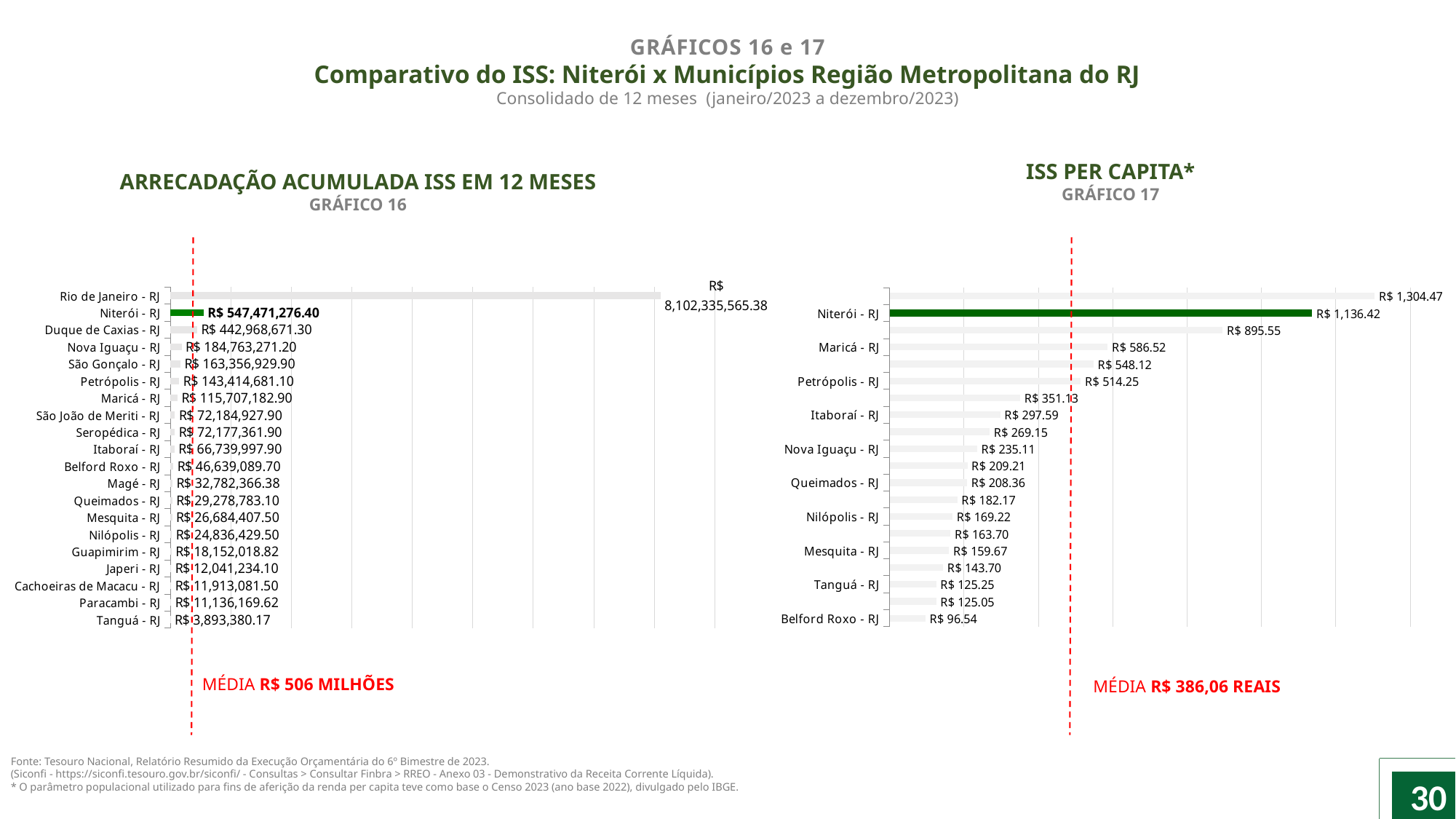
In the chart 'ISS per capita' (Gráfico 17), which is larger, the value for Petrópolis - RJ or the value for Itaboraí - RJ? Petrópolis - RJ In the chart 'ISS per capita' (Gráfico 17), what is the value for Niterói - RJ? R$ 1,136.42 In the chart 'Arrecadação Acumulada ISS em 12 meses' (Gráfico 16), how many municipalities are shown? 20 In the chart 'Arrecadação Acumulada ISS em 12 meses' (Gráfico 16), which municipality has the highest value? Rio de Janeiro - RJ In the chart 'Arrecadação Acumulada ISS em 12 meses' (Gráfico 16), what is the difference between Niterói - RJ and Duque de Caxias - RJ? R$ 104,502,605.10 In the chart 'Arrecadação Acumulada ISS em 12 meses' (Gráfico 16), which municipality has the lowest value? Tanguá - RJ What type of chart is 'ISS per capita' (Gráfico 17)? Bar chart In the chart 'Arrecadação Acumulada ISS em 12 meses' (Gráfico 16), what average (média) is indicated by the red dashed line? R$ 506 milhões In the chart 'Arrecadação Acumulada ISS em 12 meses' (Gráfico 16), what is the value for Niterói - RJ? R$ 547,471,276.40 In the chart 'Arrecadação Acumulada ISS em 12 meses' (Gráfico 16), what is the value for Duque de Caxias - RJ? R$ 442,968,671.30 In the chart 'ISS per capita' (Gráfico 17), what is the value for Maricá - RJ? R$ 586.52 In the chart 'ISS per capita' (Gráfico 17), what is the difference between Nova Iguaçu - RJ and Queimados - RJ? R$ 26.75